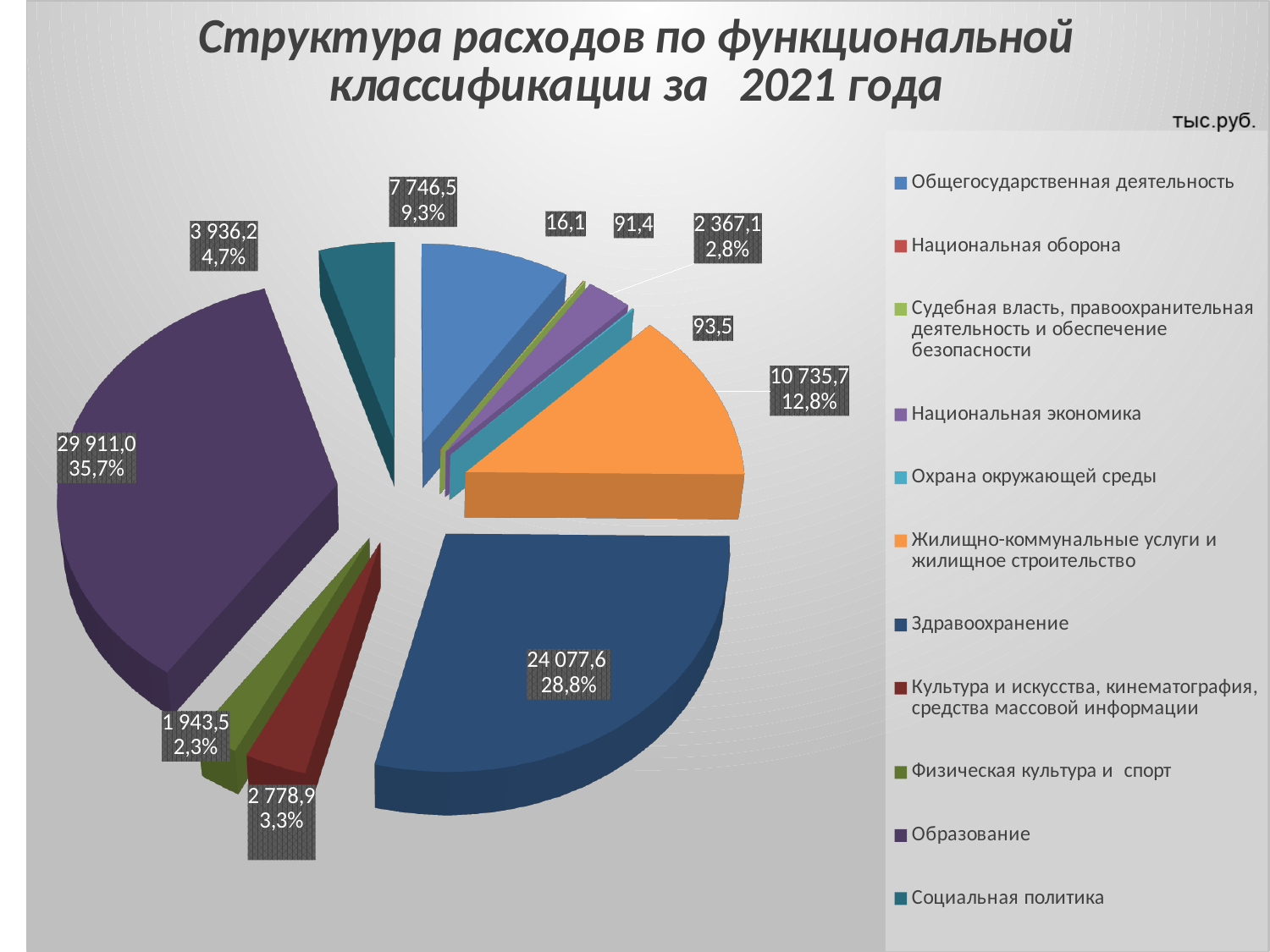
What share of the pie does Общегосударственная деятельность take? 9,3% What share of the pie does Образование take? 35,7% What is the value for Социальная политика? 3 936,2 Which category has the smallest value? Национальная оборона Which category has the largest slice? Образование How many categories does the legend list? 11 What is the difference between the values for Образование and Здравоохранение? 5 833,4 What kind of chart is shown on the slide? pie chart What is the value for Жилищно-коммунальные услуги и жилищное строительство? 10 735,7 What is the value for Здравоохранение? 24 077,6 In what units are the values given, according to the note at the top right of the chart? тыс.руб. What is the value for Образование? 29 911,0